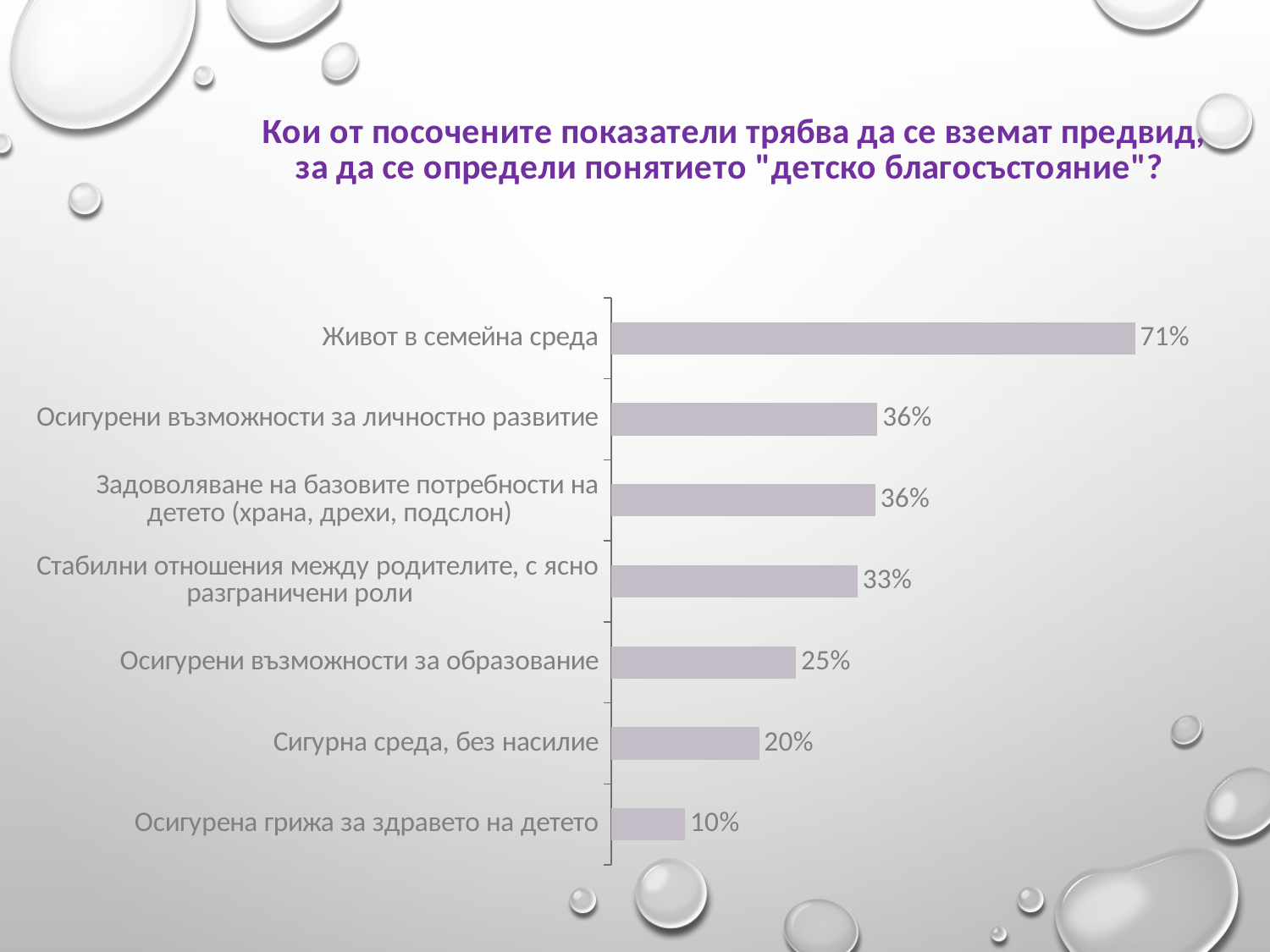
What is the value for "Стабилни отношения между родителите, с ясно разграничени роли"? 33% What is the difference between the values for "Живот в семейна среда" and "Осигурени възможности за личностно развитие"? 35% Which is larger: the value for "Осигурени възможности за образование" or the value for "Сигурна среда, без насилие"? Осигурени възможности за образование What kind of chart is shown on the slide? Bar chart What is the value for "Осигурена грижа за здравето на детето"? 10% What is the difference between the values for "Осигурени възможности за образование" and "Сигурна среда, без насилие"? 5% What is the value for "Сигурна среда, без насилие"? 20% Which category has the highest value? Живот в семейна среда Which category has the lowest value? Осигурена грижа за здравето на детето What is the title of the slide? Кои от посочените показатели трябва да се вземат предвид, за да се определи понятието "детско благосъстояние"? How many categories are shown in the chart? 7 What is the value for "Живот в семейна среда"? 71%